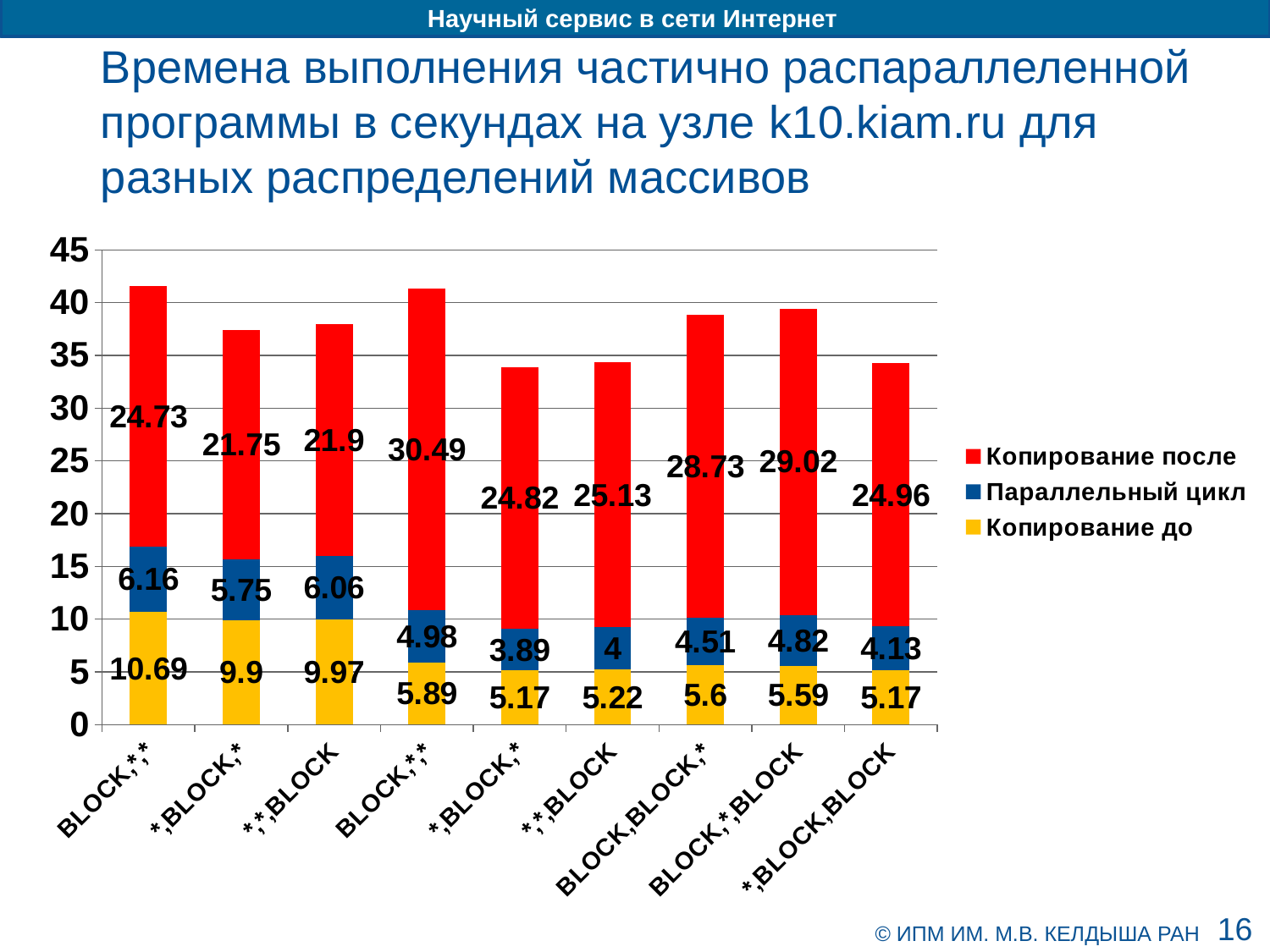
How many categories (bars) are plotted along the x axis? 9 What kind of chart is shown on the slide? stacked bar chart Which is larger: the "Параллельный цикл" value for BLOCK,BLOCK,* or for *,BLOCK,BLOCK? BLOCK,BLOCK,* What is the value of "Параллельный цикл" for the category BLOCK,*,BLOCK? 4.82 Which bar has the highest value for "Копирование после"? the fourth bar (BLOCK,*,*), 30.49 What is the difference between the "Копирование после" values for BLOCK,*,BLOCK and BLOCK,BLOCK,*? 0.29 What is the total of the stacked bar for BLOCK,*,BLOCK? 39.43 Which bar has the highest value for "Копирование до"? the first bar (BLOCK,*,*), 10.69 What is the value of "Копирование после" for the category BLOCK,BLOCK,*? 28.73 How many series does the legend list? 3 Is the total height of the first bar (BLOCK,*,*) greater or less than 40? greater What is the value of "Копирование до" for the category *,BLOCK,BLOCK? 5.17